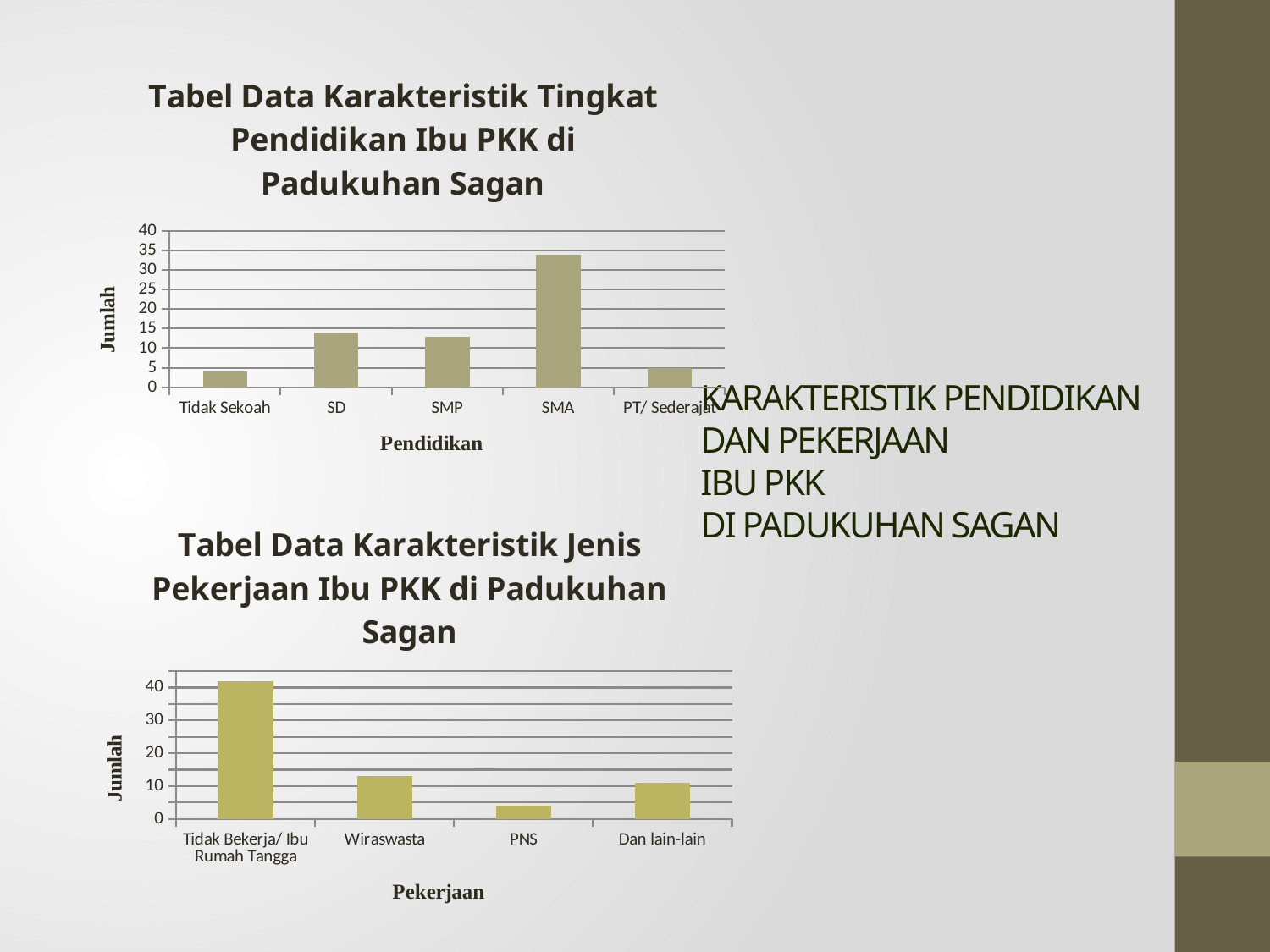
In the bottom chart (Jenis Pekerjaan), how many occupation categories are shown? 4 In the top chart (Tingkat Pendidikan), which category has the lowest value? Tidak Sekoah In the top chart (Tingkat Pendidikan), is the value for SMA greater or less than 30? greater In the bottom chart (Jenis Pekerjaan), which category has the lowest value? PNS In the bottom chart (Jenis Pekerjaan), which occupation category has the highest value? Tidak Bekerja/ Ibu Rumah Tangga In the bottom chart (Jenis Pekerjaan), is the value for Tidak Bekerja/ Ibu Rumah Tangga greater or less than 40? greater In the top chart (Tingkat Pendidikan), is the value for PT/ Sederajat greater or less than 10? less In the top chart (Tingkat Pendidikan), which is larger, the value for SMA or the value for SD? SMA What type of chart is the bottom chart (Tabel Data Karakteristik Jenis Pekerjaan Ibu PKK di Padukuhan Sagan)? Bar chart In the top chart (Tabel Data Karakteristik Tingkat Pendidikan Ibu PKK di Padukuhan Sagan), which education level has the highest value? SMA What is the label of the vertical axis on the bottom chart (Jenis Pekerjaan)? Jumlah In the top chart (Tingkat Pendidikan), how many education categories are shown on the x axis? 5